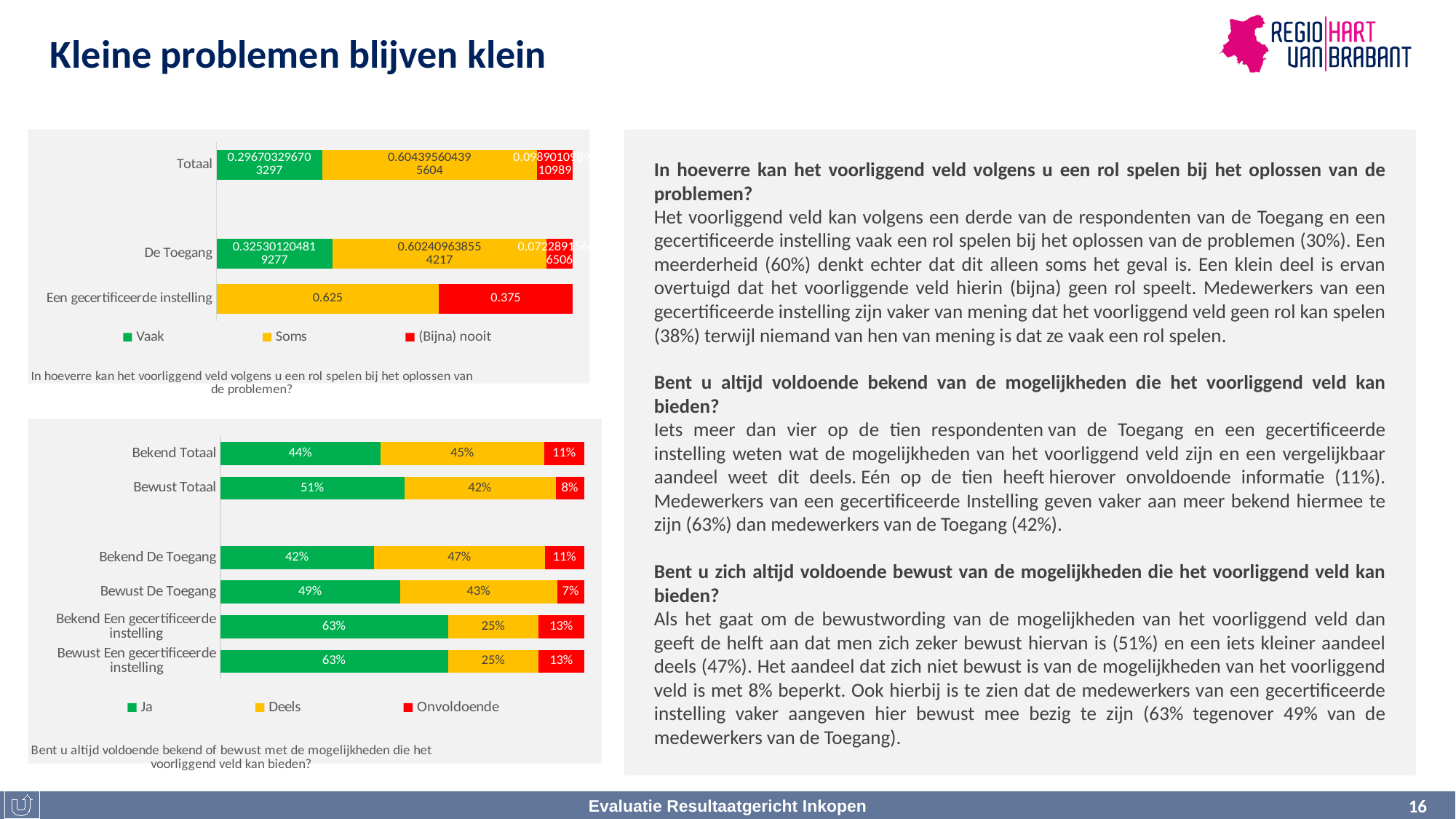
In the top chart, what is the value of the (Bijna) nooit segment for Een gecertificeerde instelling? 0.375 In the top chart, how many series does the legend list? 3 How many categories are shown in the bottom chart? 6 In the bottom chart, what is the Onvoldoende value for Bewust De Toegang? 7% In the bottom chart, what is the Deels value for Bekend De Toegang? 47% In the bottom chart, which is larger: the Deels value for Bekend Totaal or the Deels value for Bewust Totaal? Bekend Totaal In the bottom chart, what is the Ja value for Bewust Totaal? 51% What kind of chart is the bottom chart? Stacked bar chart In the bottom chart, which category has the lowest Onvoldoende value? Bewust De Toegang In the top chart, what is the value of the Soms segment for Een gecertificeerde instelling? 0.625 In the top chart, which category has the largest (Bijna) nooit segment? Een gecertificeerde instelling In the bottom chart, what is the difference between the Ja values for Bekend Een gecertificeerde instelling and Bekend De Toegang? 21%